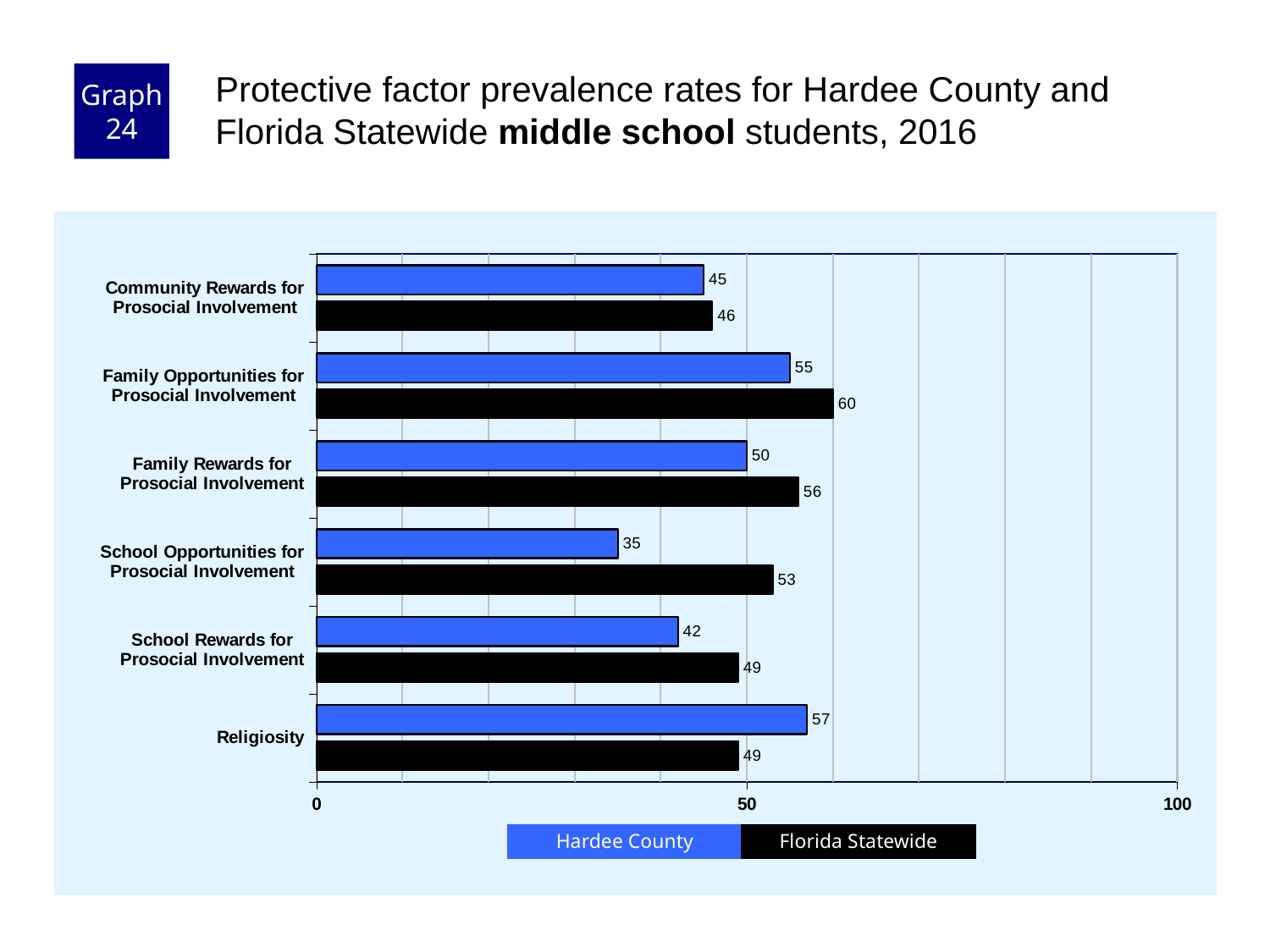
How many series does the legend list? 2 Which category has the highest Hardee County value? Religiosity Is the Hardee County value for Family Rewards for Prosocial Involvement greater or less than 50? Neither, it is exactly 50 Which category has the lowest Hardee County value? School Opportunities for Prosocial Involvement Which category has the lowest Florida Statewide value? Community Rewards for Prosocial Involvement How many categories are shown on the chart? 6 Which is larger for Religiosity, the Hardee County value or the Florida Statewide value? Hardee County What is the difference between the Florida Statewide and Hardee County values for School Opportunities for Prosocial Involvement? 18 What is the Florida Statewide value for Family Opportunities for Prosocial Involvement? 60 What is the Hardee County value for School Opportunities for Prosocial Involvement? 35 What kind of chart is shown on the slide? Bar chart What is the Hardee County value for Religiosity? 57